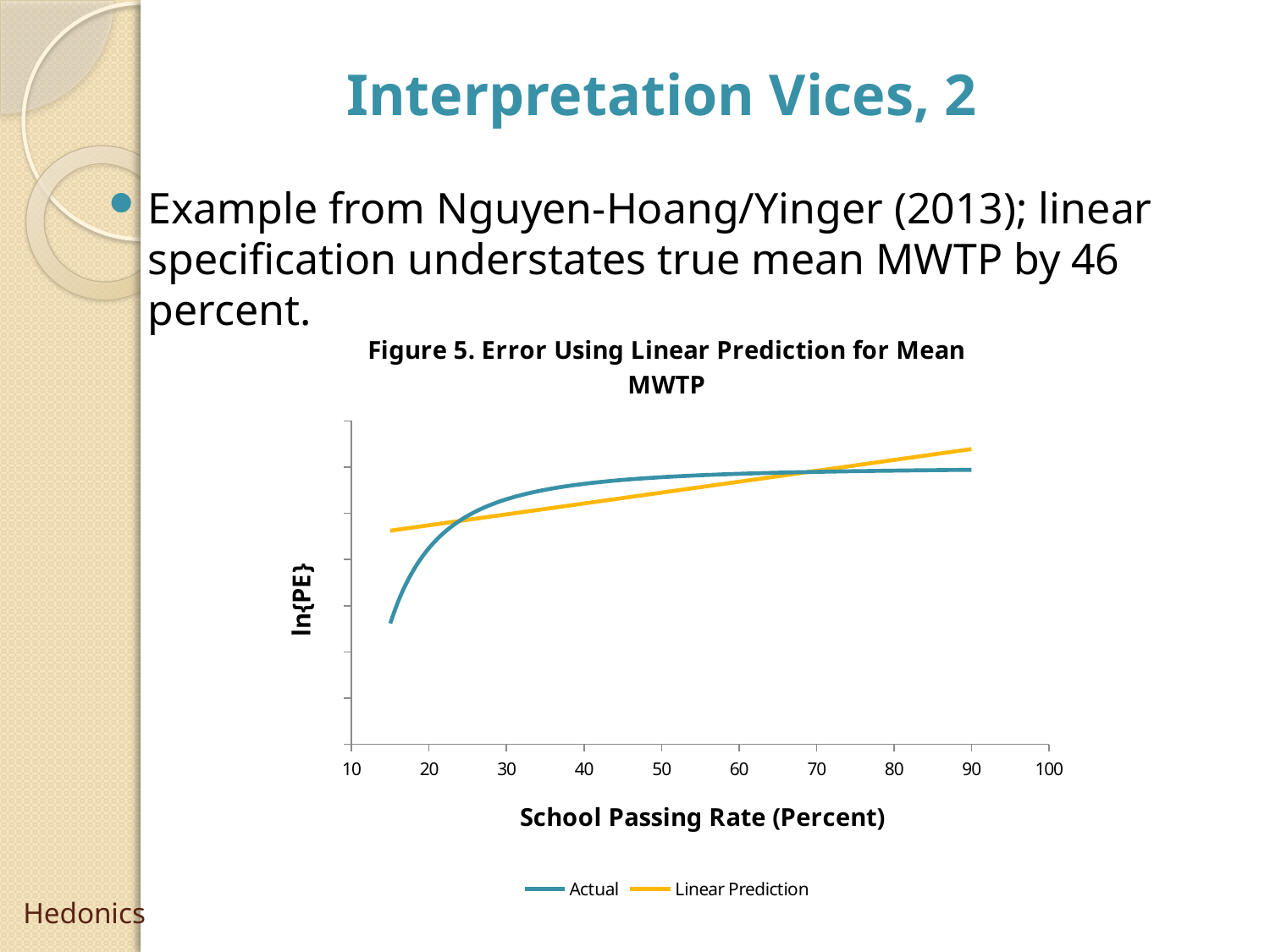
How many series does the chart's legend list? 2 What is the highest value shown on the chart's x axis? 100 At a school passing rate of 40 percent, which series has the higher value, Actual or Linear Prediction? Actual What is the title of the chart? Figure 5. Error Using Linear Prediction for Mean MWTP At a school passing rate of 90 percent, which series has the higher value, Actual or Linear Prediction? Linear Prediction What is the label of the chart's x axis? School Passing Rate (Percent) Does the Actual series rise or fall as the school passing rate increases? rise What kind of chart is shown on the slide? line chart Does the Linear Prediction series rise or fall as the school passing rate increases? rise At a school passing rate of 15 percent, which series has the higher value, Actual or Linear Prediction? Linear Prediction Which series shows a curved (non-linear) shape, Actual or Linear Prediction? Actual